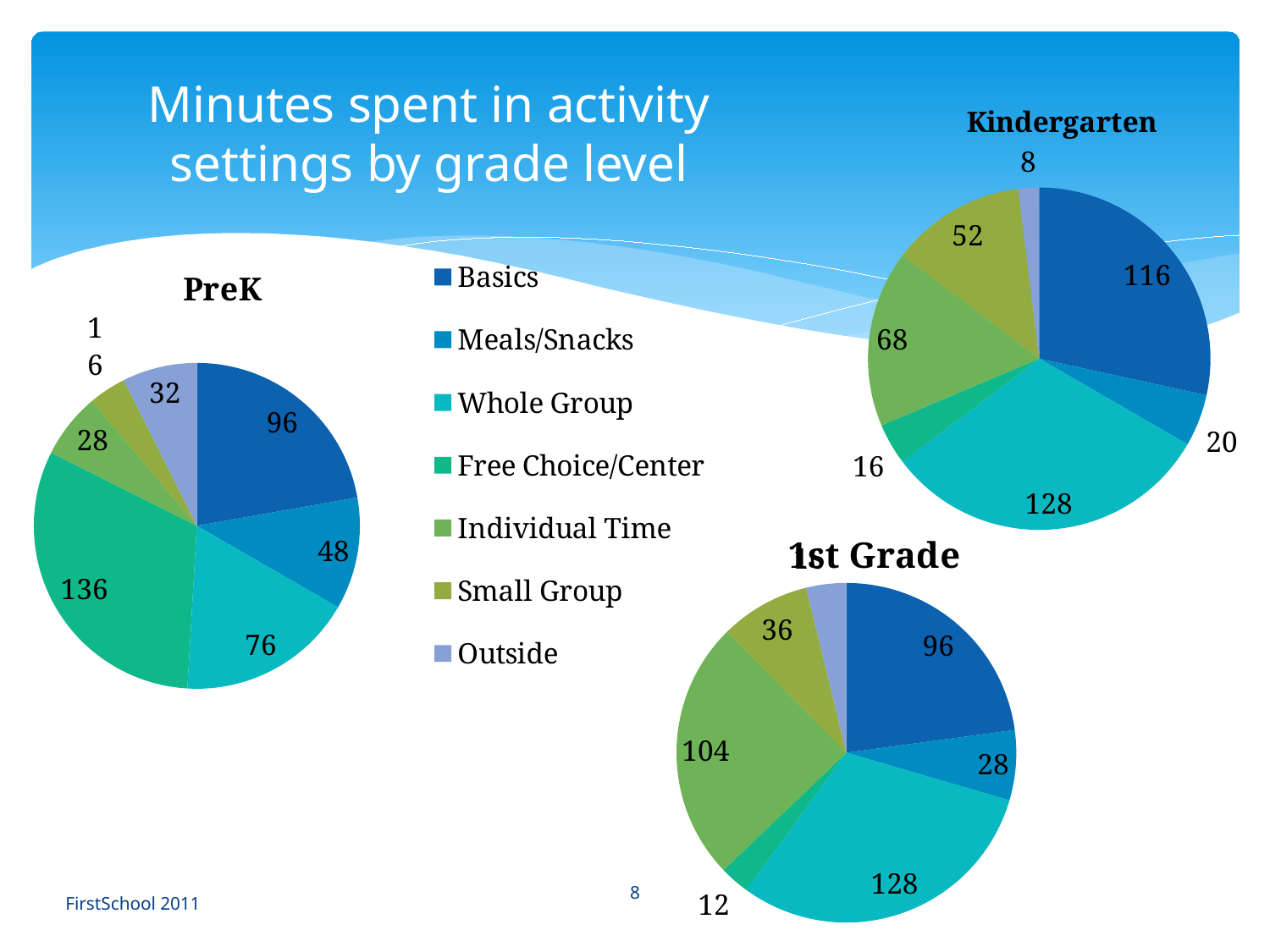
In the 1st Grade chart, which is larger, Whole Group or Basics? Whole Group How many activity settings does the legend list? 7 In the Kindergarten chart, which activity setting has the smallest slice? Outside In the Kindergarten chart, how much larger is Whole Group than Basics? 12 In the 1st Grade chart, how many minutes are spent in Individual Time? 104 In the 1st Grade chart, what is the value for Meals/Snacks? 28 In the Kindergarten chart, how many minutes are spent in Basics? 116 In the Kindergarten chart, which activity setting has the largest slice? Whole Group In the PreK chart, how many minutes are spent in Free Choice/Center? 136 What kind of chart is used to show the minutes for each grade level? Pie chart In the PreK chart, what is the value for Whole Group? 76 In the PreK chart, what is the difference between Free Choice/Center and Basics? 40